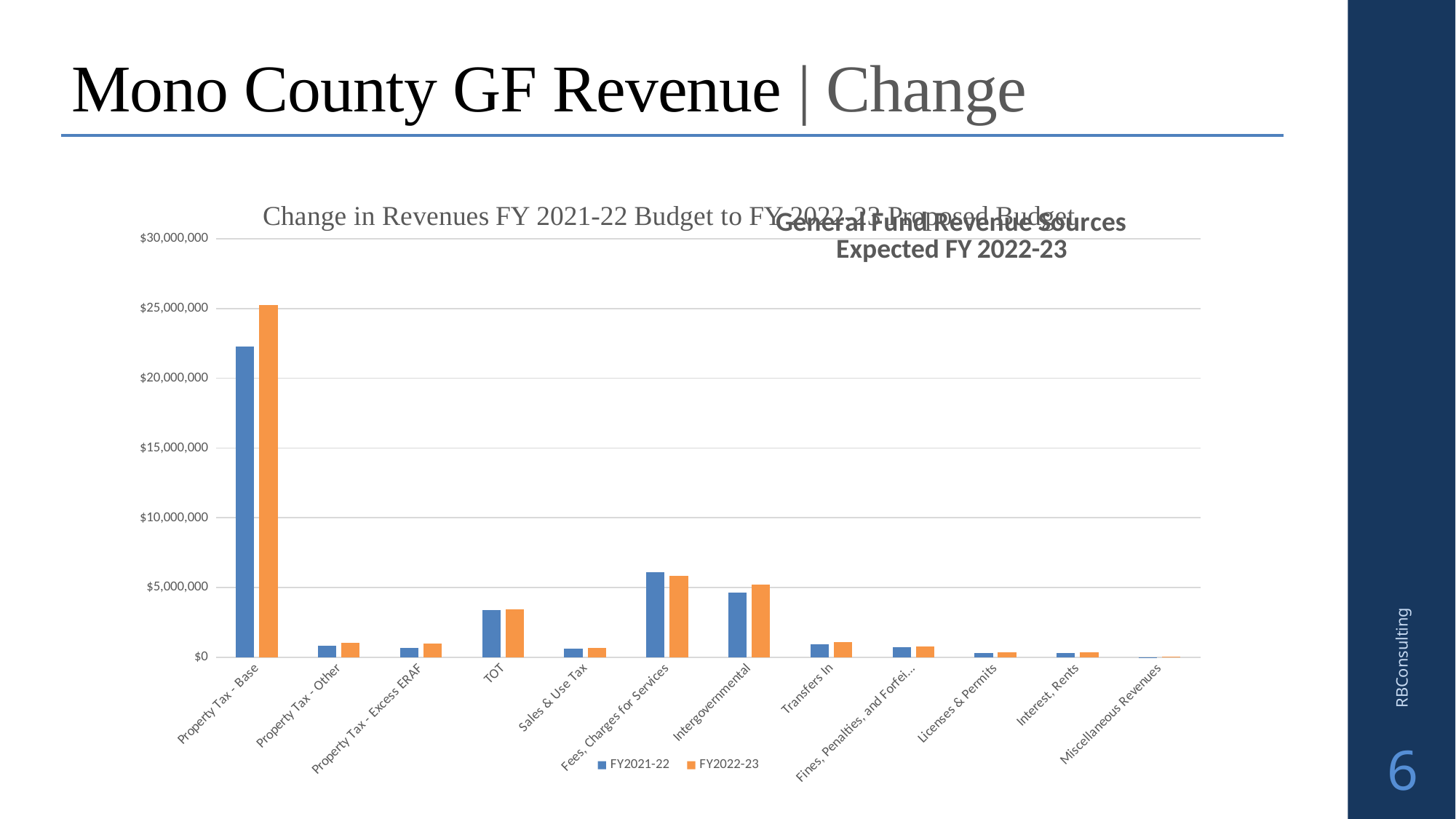
Is the FY2021-22 value for Fees, Charges for Services greater or less than $5,000,000? greater How many series does the chart legend list? 2 Is the FY2022-23 value for TOT greater or less than $5,000,000? less What kind of chart is shown on the slide? bar chart Is the FY2021-22 value for Property Tax - Base greater or less than $20,000,000? greater Which revenue category has the highest FY2022-23 value? Property Tax - Base Which revenue category has the lowest FY2021-22 value? Miscellaneous Revenues For Property Tax - Base, which series has the larger value, FY2021-22 or FY2022-23? FY2022-23 For Fees, Charges for Services, which series has the larger value, FY2021-22 or FY2022-23? FY2021-22 Which colour represents the FY2022-23 series in the chart? orange For Intergovernmental, which series has the larger value, FY2021-22 or FY2022-23? FY2022-23 How many revenue categories are shown along the x axis of the chart? 12